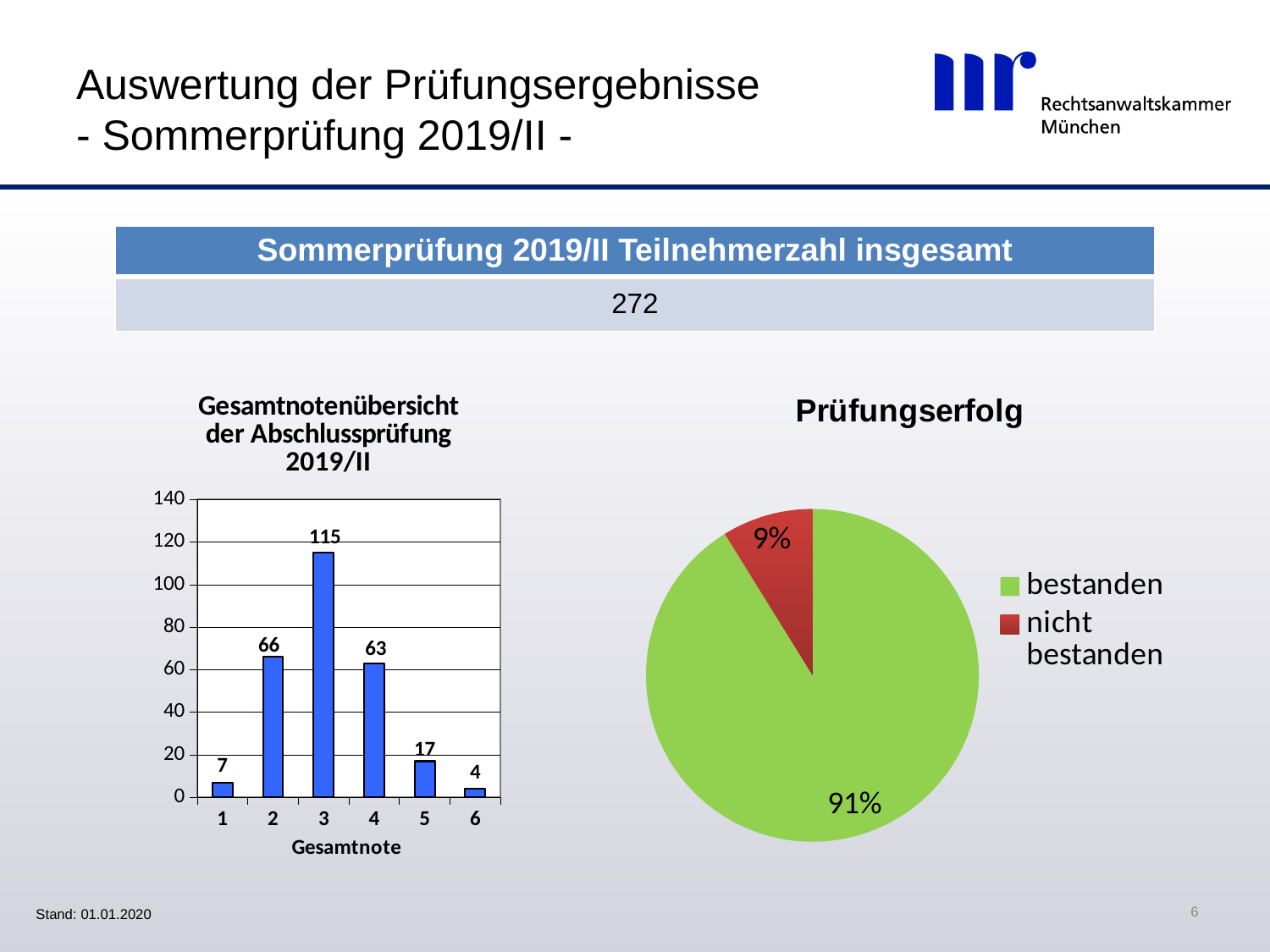
What kind of chart is 'Gesamtnotenübersicht der Abschlussprüfung 2019/II'? bar chart In the bar chart 'Gesamtnotenübersicht der Abschlussprüfung 2019/II', which Gesamtnote has the lowest value? 6 In the bar chart 'Gesamtnotenübersicht der Abschlussprüfung 2019/II', which Gesamtnote has the highest value? 3 In the pie chart 'Prüfungserfolg', what share is 'nicht bestanden'? 9% In the bar chart 'Gesamtnotenübersicht der Abschlussprüfung 2019/II', what is the difference between the values for Gesamtnote 2 and Gesamtnote 4? 3 In the bar chart 'Gesamtnotenübersicht der Abschlussprüfung 2019/II', what is the value for Gesamtnote 3? 115 How many entries does the legend of the pie chart 'Prüfungserfolg' list? 2 In the bar chart 'Gesamtnotenübersicht der Abschlussprüfung 2019/II', is the value for Gesamtnote 3 greater or less than 100? greater In the pie chart 'Prüfungserfolg', what share is 'bestanden'? 91% In the bar chart 'Gesamtnotenübersicht der Abschlussprüfung 2019/II', which is larger: the value for Gesamtnote 1 or Gesamtnote 6? Gesamtnote 1 How many Gesamtnote categories are shown in the bar chart 'Gesamtnotenübersicht der Abschlussprüfung 2019/II'? 6 In the bar chart 'Gesamtnotenübersicht der Abschlussprüfung 2019/II', what is the value for Gesamtnote 5? 17